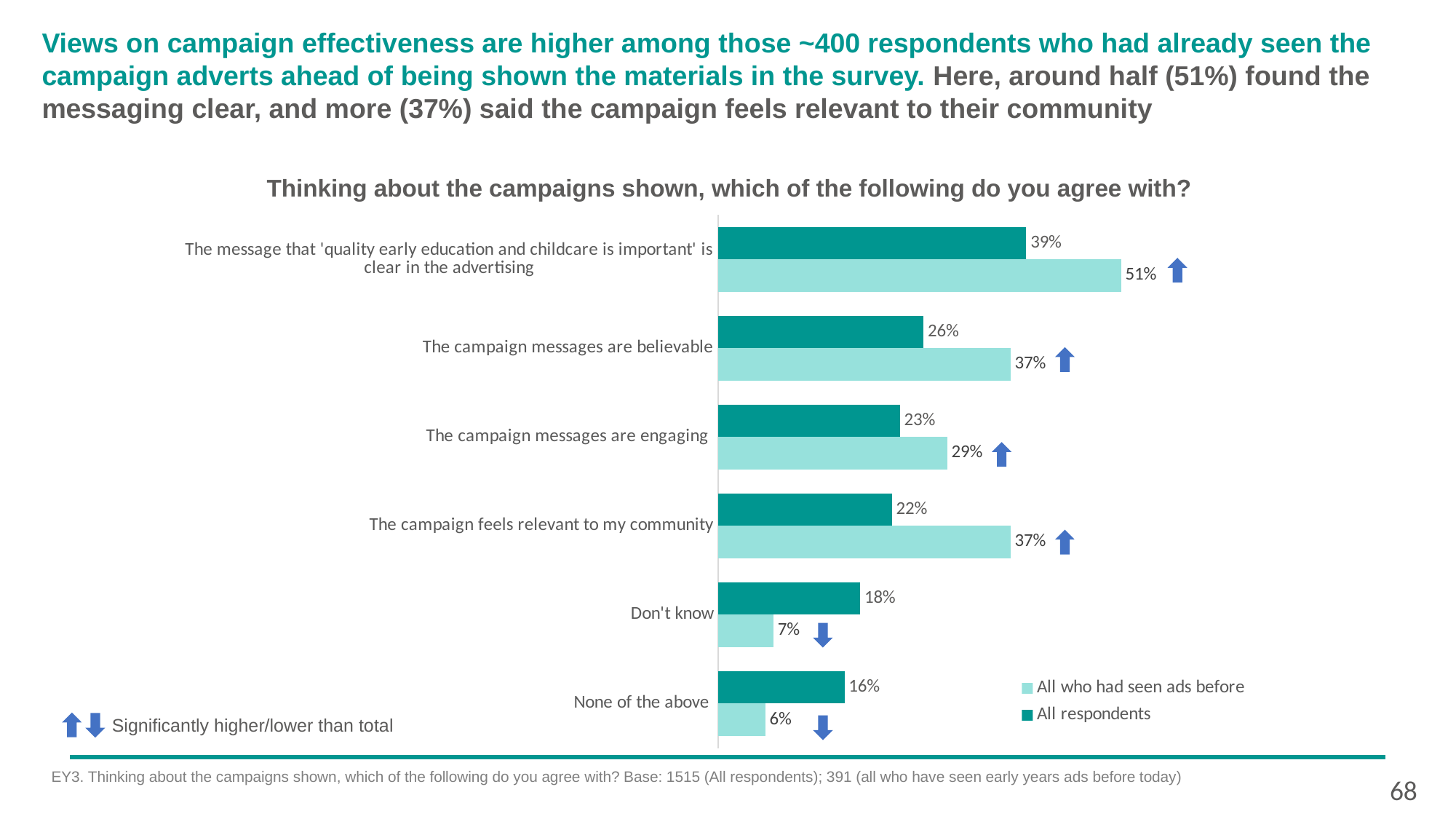
What percentage of all respondents agreed that the campaign messages are believable? 26% What is the title of the chart? Thinking about the campaigns shown, which of the following do you agree with? How many series does the legend list? 2 Which category has the lowest value among all who had seen ads before? None of the above What is the difference between all who had seen ads before and all respondents for the statement that the message is clear in the advertising? 12 percentage points For 'The campaign messages are engaging', which group has the larger value: all respondents or all who had seen ads before? All who had seen ads before What percentage of all who had seen ads before agreed that the campaign feels relevant to my community? 37% What percentage of all respondents selected 'Don't know'? 18% How many categories are shown on the chart? 6 For 'Don't know', which group has the larger value: all respondents or all who had seen ads before? All respondents What type of chart is shown on the slide? Bar chart Which statement has the highest value among all who had seen ads before? The message that 'quality early education and childcare is important' is clear in the advertising